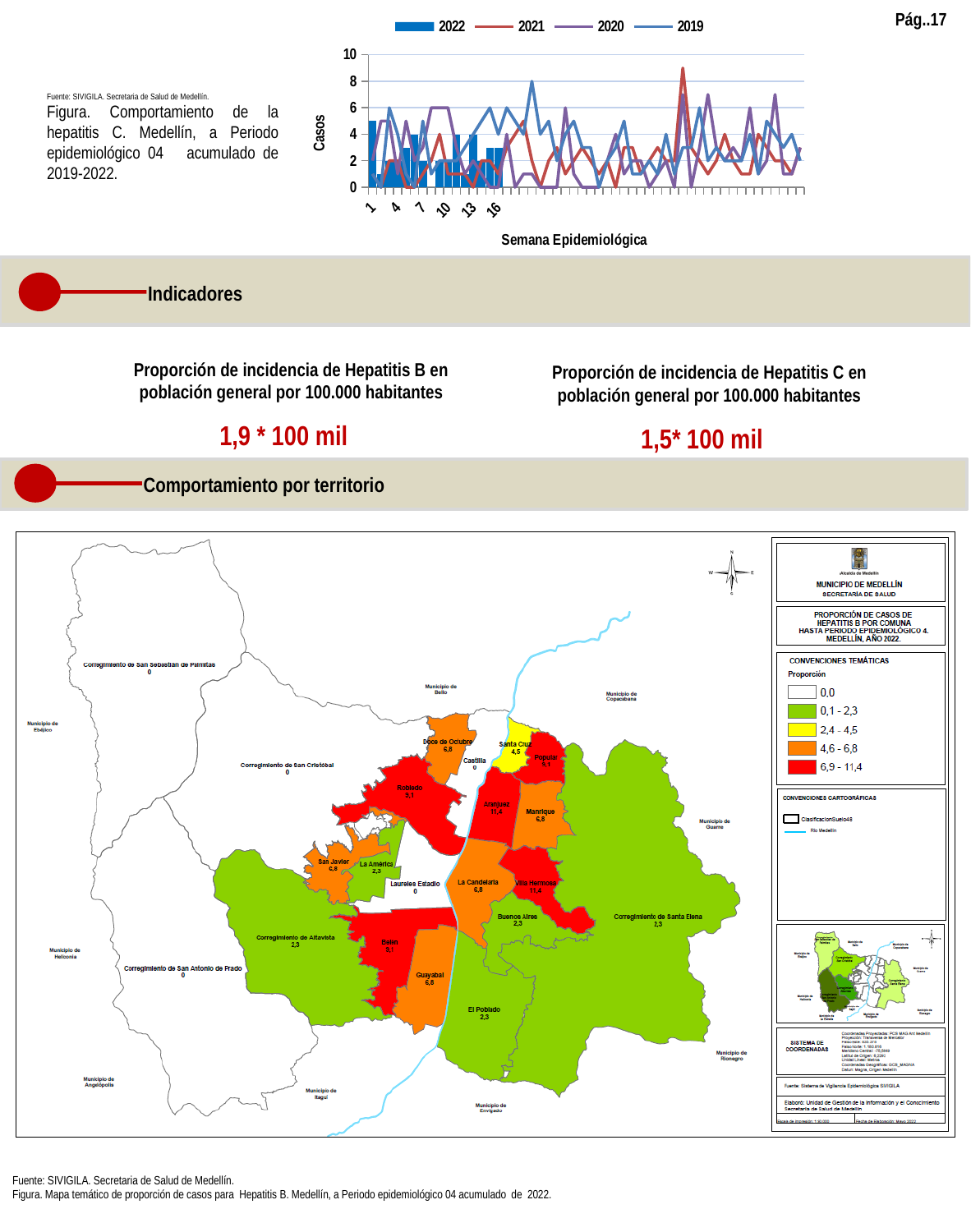
What are the series listed in the legend of the top chart? 2022, 2021, 2020, 2019 Which series in the top chart is drawn as bars rather than a line? 2022 In the top chart, which series reaches the highest number of cases in any week? 2021 What kind of chart is the top chart showing hepatitis C cases by epidemiological week? Combined bar and line chart How many series does the legend of the top chart list? 4 What is the title of the horizontal axis of the top chart? Semana Epidemiológica In the top chart, is the highest value reached by the 2021 line greater or less than 8? greater In the top chart, is the highest value reached by the 2019 line greater or less than 6? greater What is the title of the vertical axis of the top chart? Casos In the top chart, is the 2022 bar for week 1 greater or less than 4? greater What is the maximum value shown on the vertical axis of the top chart? 10